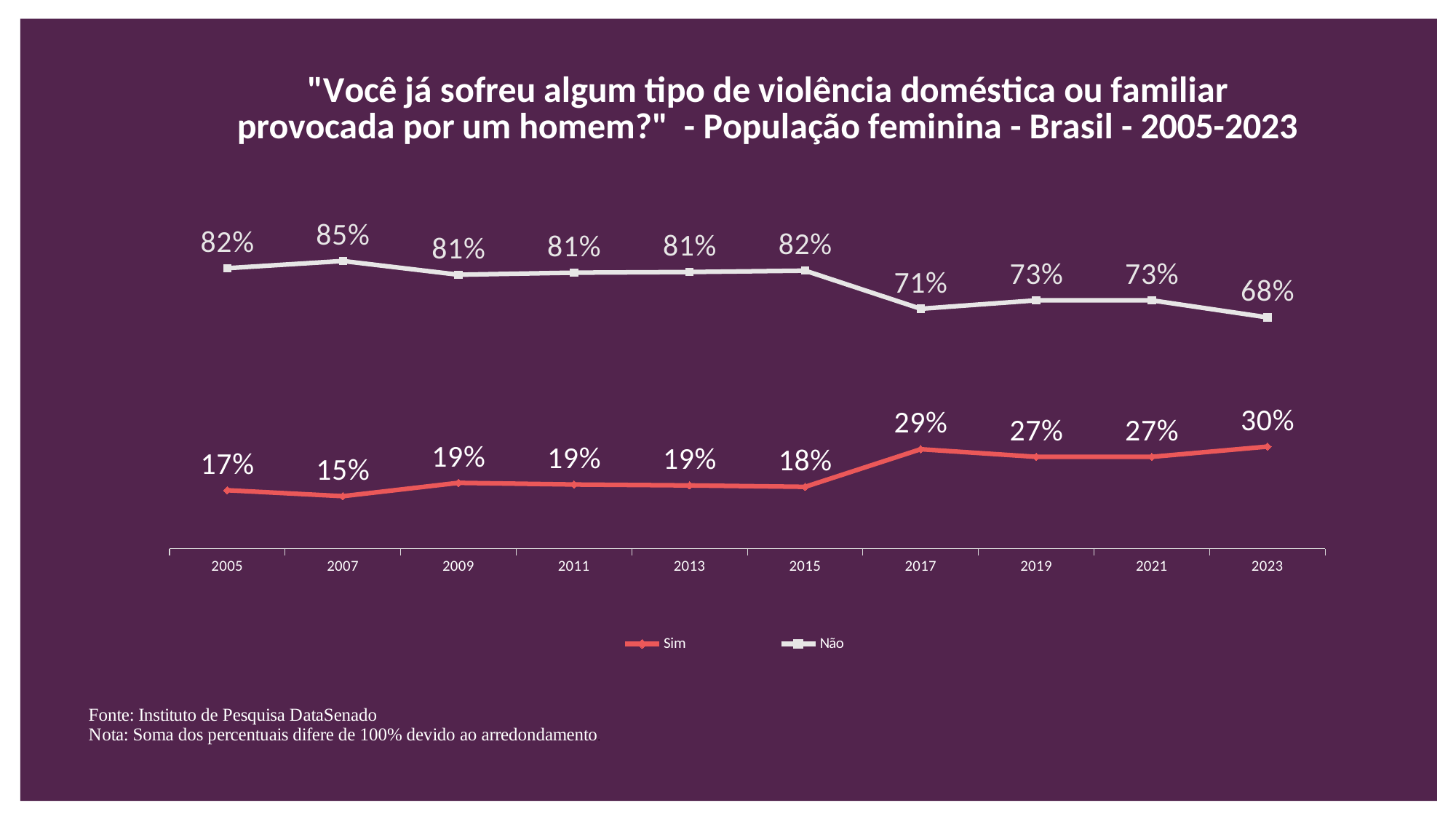
What is the value for "Não" in 2007? 85% How many series does the legend list? 2 What kind of chart is shown? Line chart What is the value for "Sim" in 2023? 30% What is the difference between the "Sim" values in 2017 and 2015? 11 percentage points Which is larger, the "Não" value in 2015 or in 2017? 2015 In which year is the "Não" series at its lowest? 2023 In which year is the "Não" series at its highest? 2007 In which year is the "Sim" series at its lowest? 2007 What is the value for "Sim" in 2015? 18% How many years are shown on the x axis? 10 Does the "Sim" series generally rise or fall from 2005 to 2023? Rise